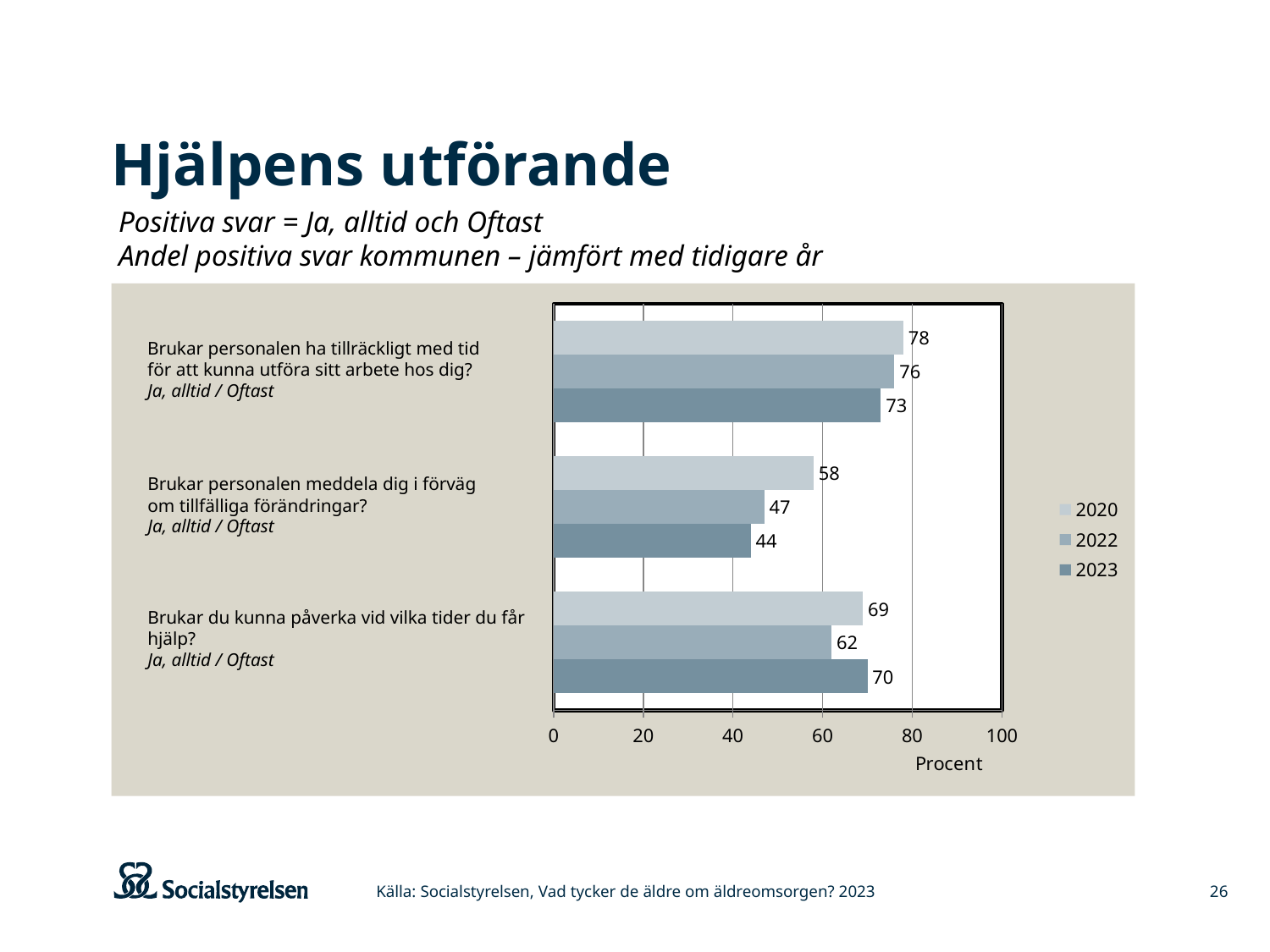
Is the 2022 value for "Brukar personalen meddela dig i förväg om tillfälliga förändringar?" greater or less than 60? less What is the 2022 value for "Brukar du kunna påverka vid vilka tider du får hjälp?"? 62 What is the label on the horizontal axis of the chart? Procent How many question categories are plotted on the chart? 3 What is the difference between the 2020 and 2023 values for "Brukar personalen meddela dig i förväg om tillfälliga förändringar?"? 14 For "Brukar du kunna påverka vid vilka tider du får hjälp?", which is larger, the 2022 value or the 2023 value? 2023 What is the 2020 value for "Brukar personalen meddela dig i förväg om tillfälliga förändringar?"? 58 Which question has the highest 2020 value? Brukar personalen ha tillräckligt med tid för att kunna utföra sitt arbete hos dig? What is the 2023 value for "Brukar personalen ha tillräckligt med tid för att kunna utföra sitt arbete hos dig?"? 73 Which question has the lowest 2023 value? Brukar personalen meddela dig i förväg om tillfälliga förändringar? What kind of chart is shown on the slide? bar chart How many series does the legend list? 3